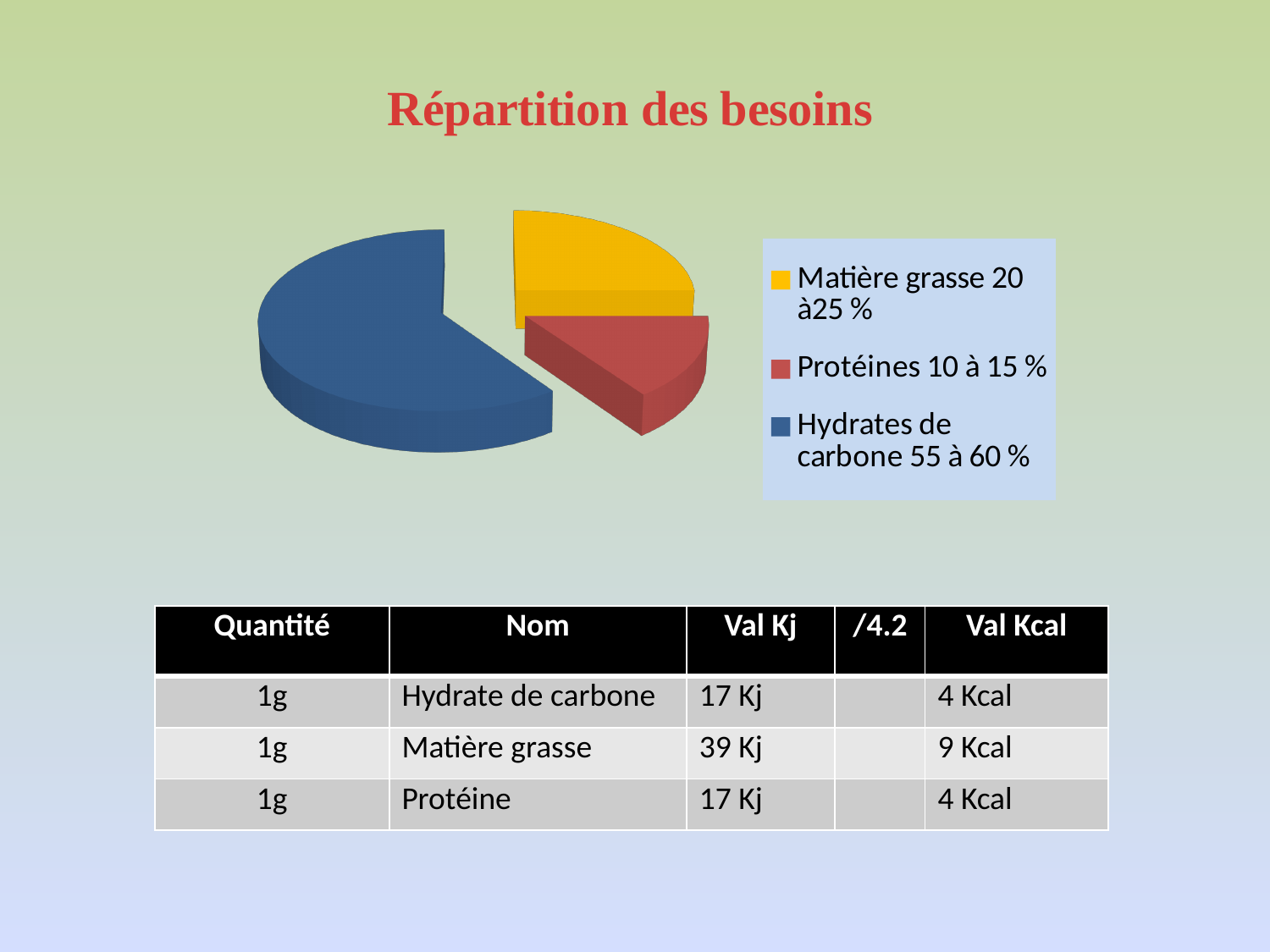
How many slices does the pie chart have? 3 Which slice is larger in the pie chart, Matière grasse or Protéines? Matière grasse Which category has the largest slice in the pie chart? Hydrates de carbone 55 à 60 % What kind of chart is shown on the slide? pie chart What colour is the Hydrates de carbone slice in the pie chart? blue Which slice is larger in the pie chart, Hydrates de carbone or Matière grasse? Hydrates de carbone Which category has the smallest slice in the pie chart? Protéines 10 à 15 % How many entries does the legend of the pie chart list? 3 What is the title of the slide containing the pie chart? Répartition des besoins